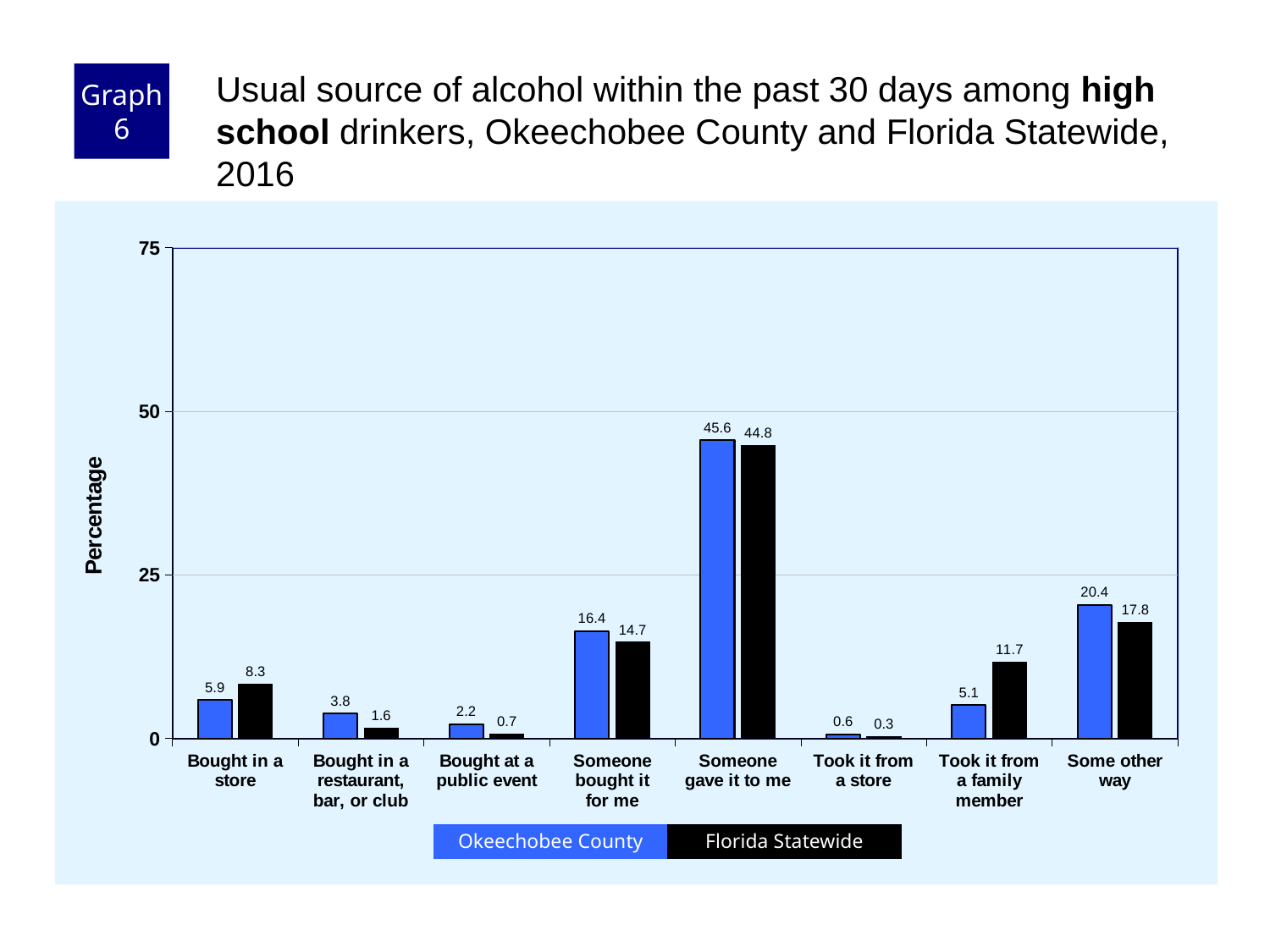
Which category has the highest Florida Statewide value? Someone gave it to me Is the Okeechobee County value for "Someone bought it for me" greater or less than 25? less How many series does the legend list? 2 Which is larger for "Bought in a store": Okeechobee County or Florida Statewide? Florida Statewide What is the Okeechobee County value for "Someone gave it to me"? 45.6 What kind of chart is shown on the slide? Bar chart How many categories are shown on the x axis? 8 Which category has the lowest Okeechobee County value? Took it from a store What is the Okeechobee County value for "Bought in a restaurant, bar, or club"? 3.8 What colour are the Florida Statewide bars? Black What is the Florida Statewide value for "Took it from a family member"? 11.7 What is the difference between the Okeechobee County and Florida Statewide values for "Some other way"? 2.6